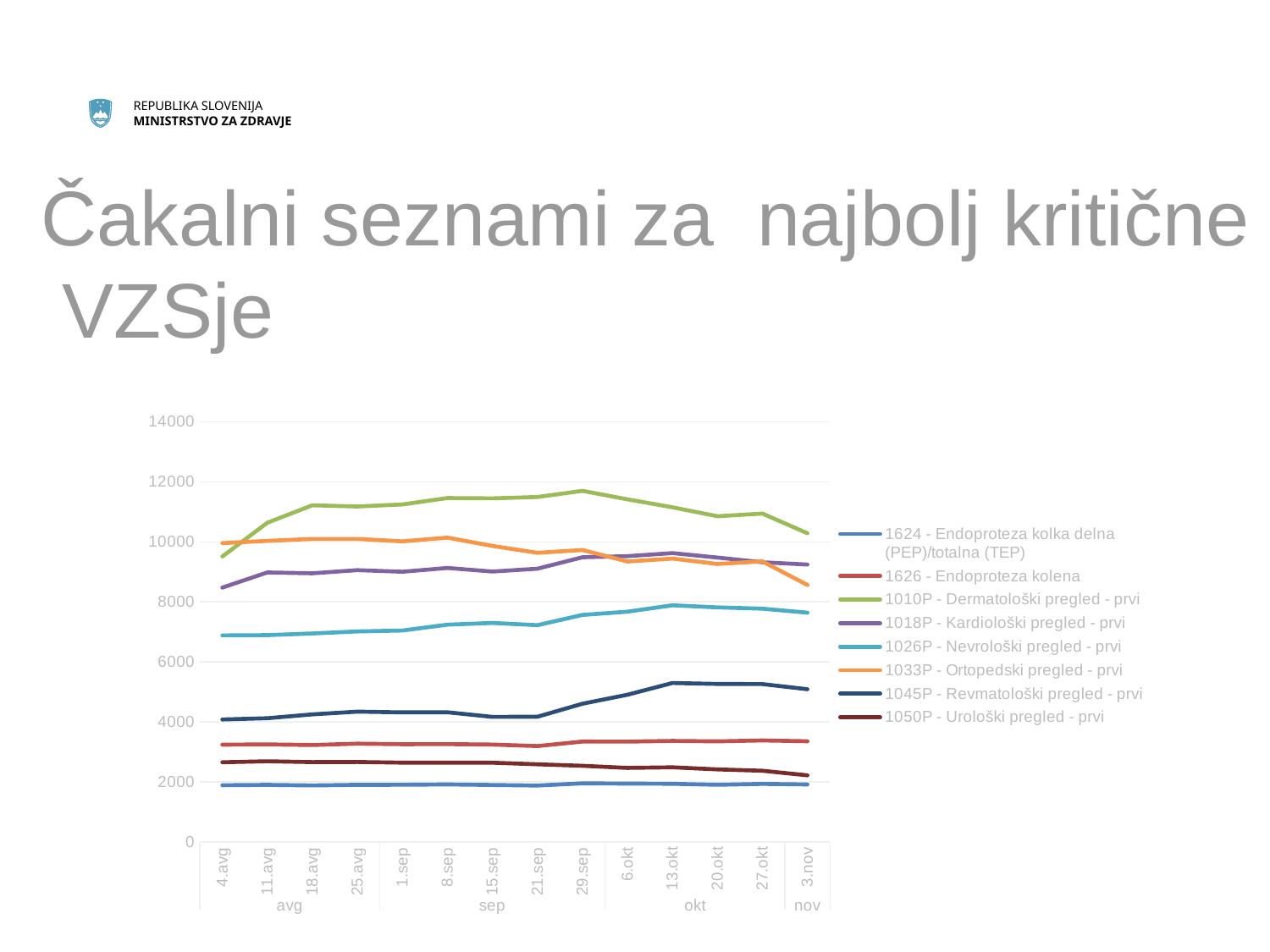
Which series has the highest values across the chart? 1010P - Dermatološki pregled - prvi Is the value for 1045P - Revmatološki pregled - prvi at 13.okt greater or less than 4000? greater How many dates are shown along the x axis? 14 Is the value for 1033P - Ortopedski pregled - prvi at 3.nov greater or less than 10000? less Which series has the lowest values across the chart? 1624 - Endoproteza kolka delna (PEP)/totalna (TEP) Is the value for 1010P - Dermatološki pregled - prvi at 29.sep greater or less than 10000? greater What kind of chart is shown on the slide? line chart Does the line for 1045P - Revmatološki pregled - prvi rise or fall from 4.avg to 13.okt? rise How many series does the legend list? 8 At 4.avg, which is larger: 1018P - Kardiološki pregled - prvi or 1026P - Nevrološki pregled - prvi? 1018P - Kardiološki pregled - prvi What is the title of the slide containing the chart? Čakalni seznami za najbolj kritične VZSje